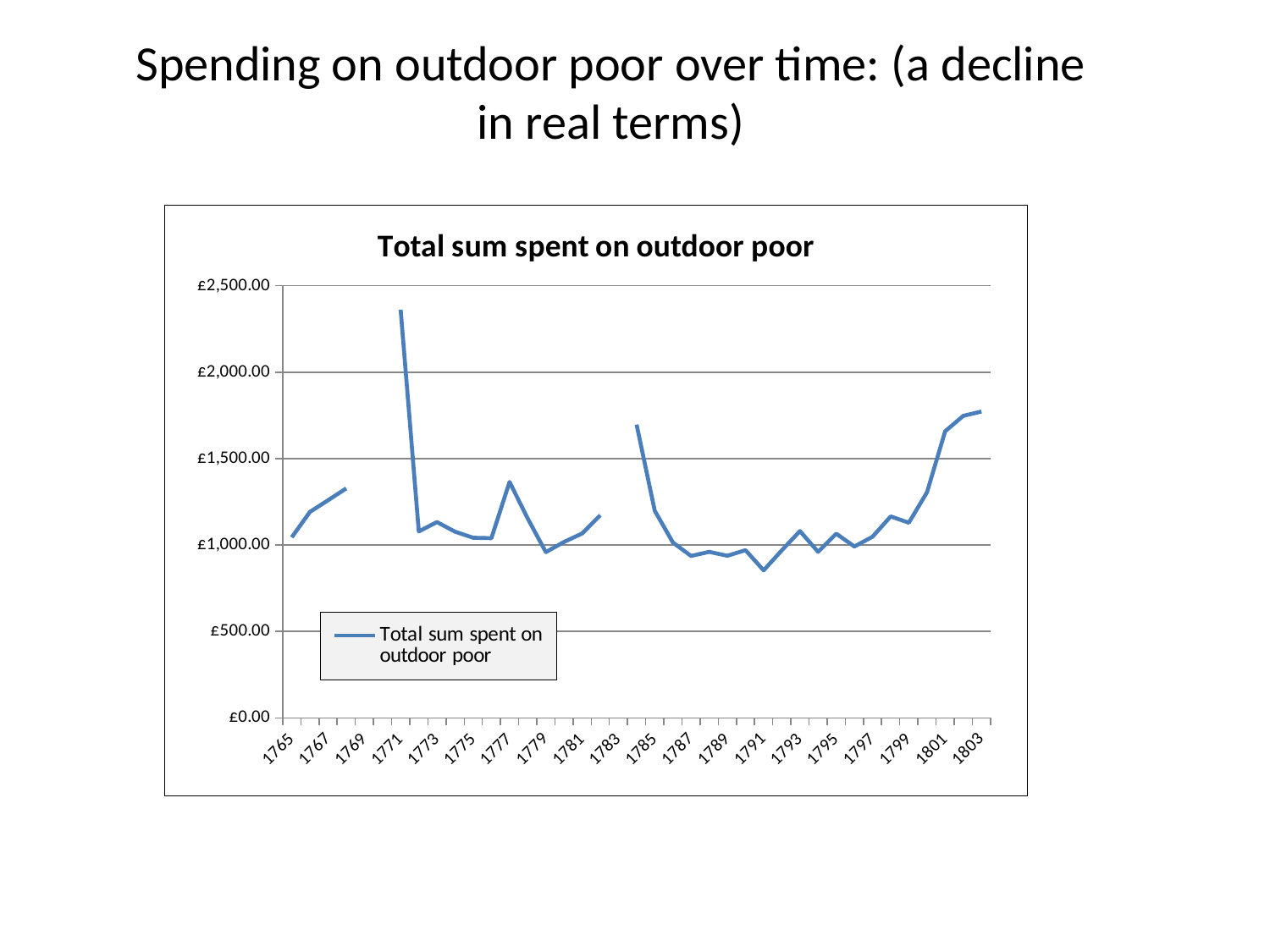
How many series does the legend list? 1 Is the value for 1803 greater or less than £1,500.00? greater Is the value for 1777 greater or less than £1,000.00? greater Which year has the larger value, 1771 or 1785? 1771 What kind of chart is shown on the slide? line chart In which year is the total sum spent on outdoor poor lowest? 1791 Is the value for 1791 greater or less than £1,000.00? less In which year is the total sum spent on outdoor poor highest? 1771 What is the legend entry for the plotted line? Total sum spent on outdoor poor What is the title of the chart? Total sum spent on outdoor poor Does the total sum spent on outdoor poor rise or fall between 1797 and 1803? rise